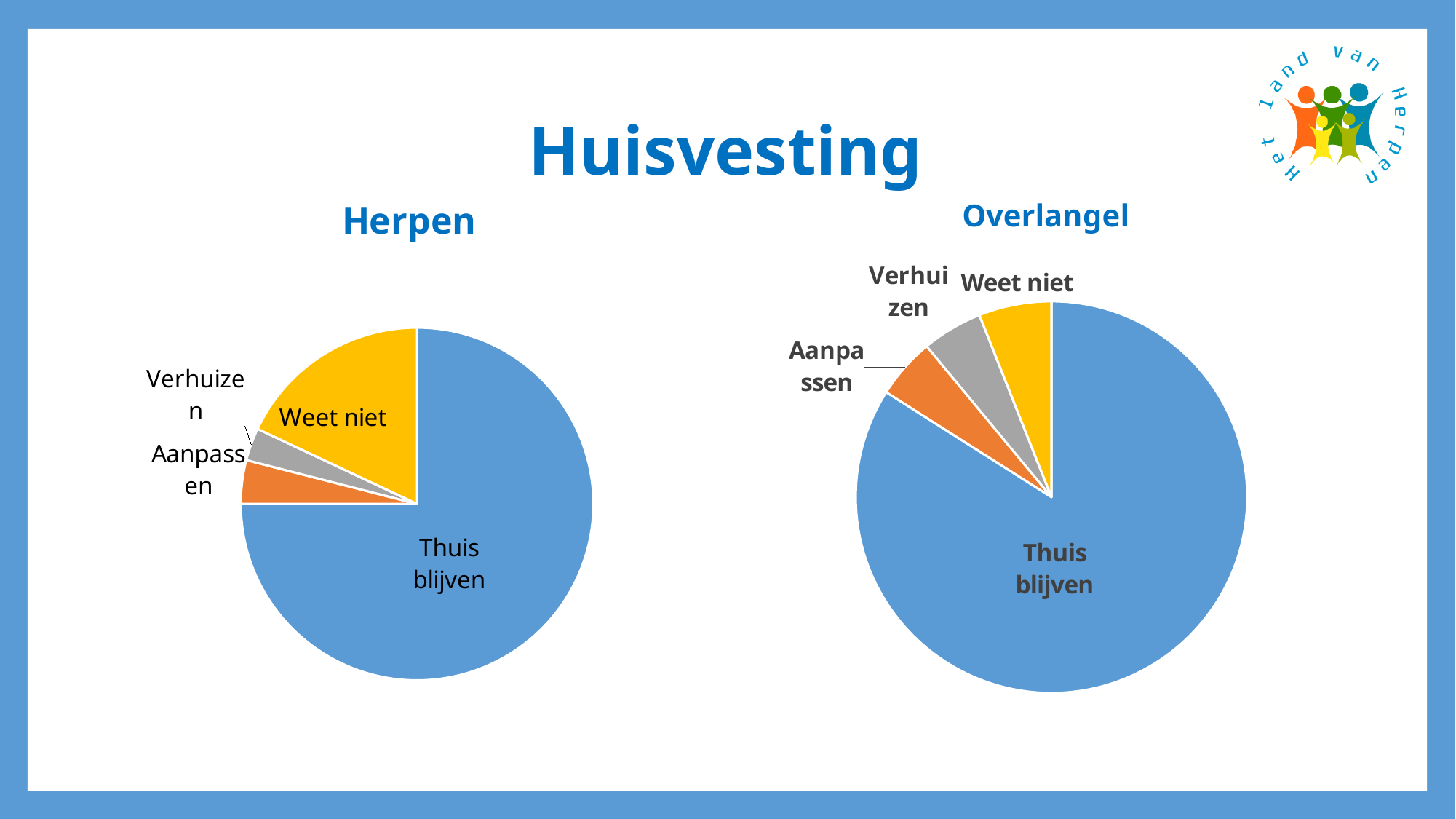
In the Overlangel chart, which is larger: Thuis blijven or Weet niet? Thuis blijven In the Herpen chart, which category has the largest slice? Thuis blijven What is the title of the slide above the two charts? Huisvesting How many slices does the Overlangel pie chart have? 4 In the Overlangel chart, which category has the largest slice? Thuis blijven What kind of chart is the Herpen chart? pie chart In the Herpen chart, which is larger: Thuis blijven or Verhuizen? Thuis blijven In the Herpen chart, which is larger: Weet niet or Aanpassen? Weet niet What kind of chart is the Overlangel chart? pie chart In the Overlangel chart, what colour is the Weet niet slice? yellow How many slices does the Herpen pie chart have? 4